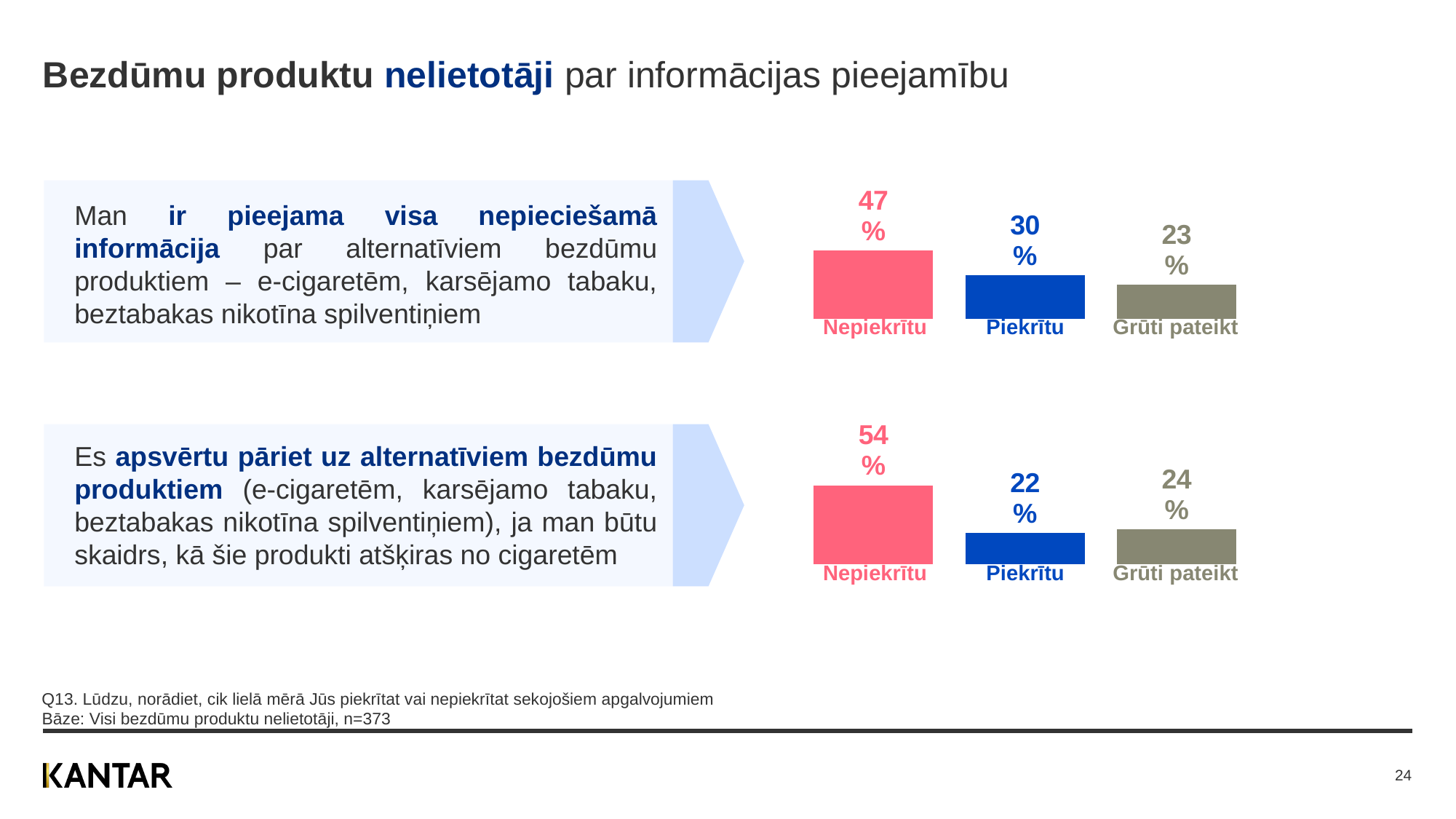
What kind of chart is the top chart? Bar chart In the top chart, what is the difference between Nepiekrītu and Piekrītu? 17% In the top chart, what is the value for Piekrītu? 30% In the bottom chart, what is the value for Piekrītu? 22% How many categories does the bottom chart show? 3 In the top chart, what is the value for Nepiekrītu? 47% In the bottom chart, what is the value for Grūti pateikt? 24% In the top chart, which category has the lowest value? Grūti pateikt In the bottom chart, what is the difference between Nepiekrītu and Grūti pateikt? 30% Which is larger: Nepiekrītu in the top chart or Nepiekrītu in the bottom chart? Nepiekrītu in the bottom chart In the bottom chart, which category has the highest value? Nepiekrītu In the top chart, which category has the highest value? Nepiekrītu